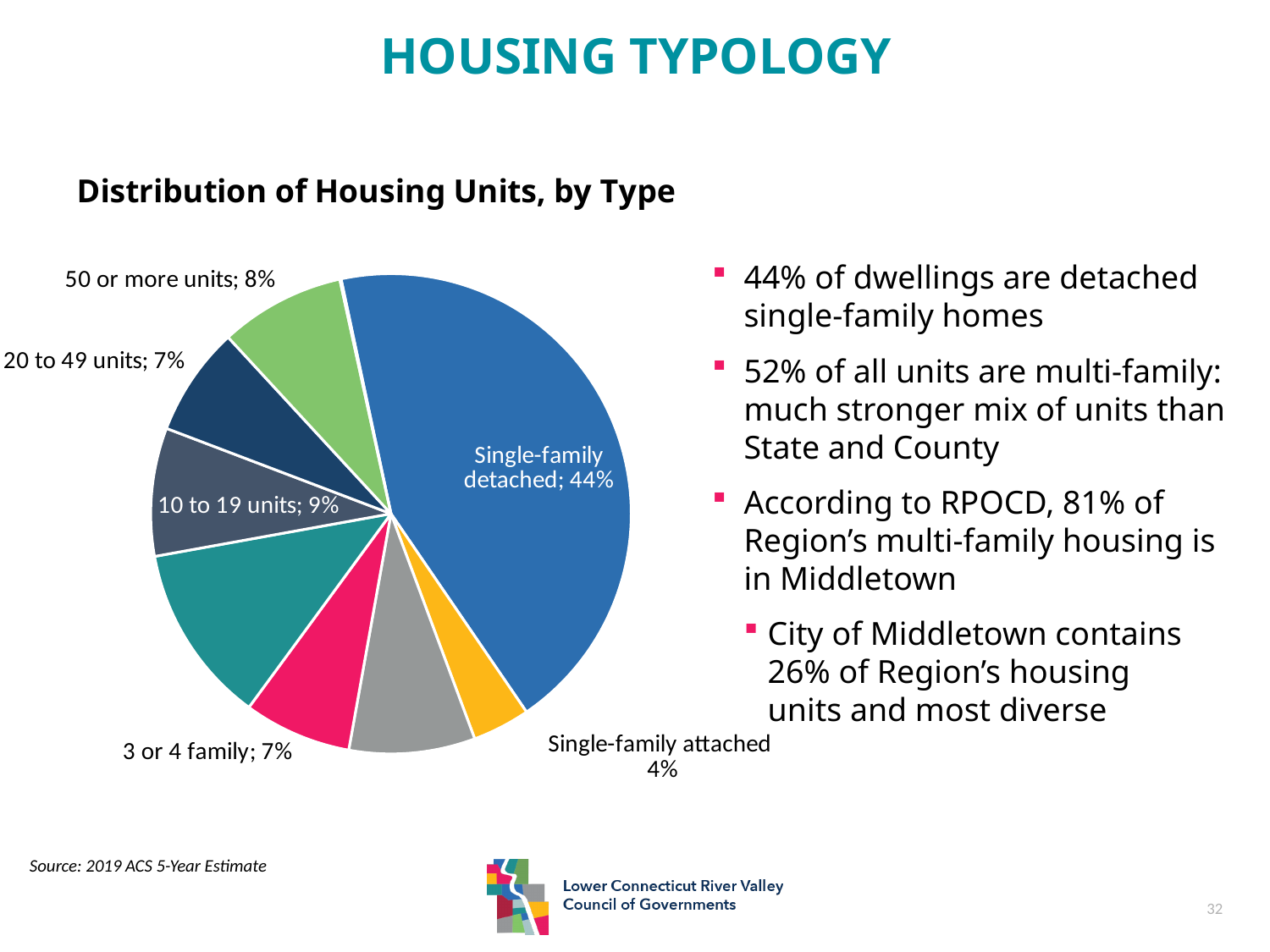
Which housing type has the smallest share of the pie? Single-family attached What share of housing units is in the 20 to 49 units category? 7% How many percentage points larger is the Single-family detached share than the 10 to 19 units share? 35% What kind of chart is shown on the slide? Pie chart Which has a larger share: 10 to 19 units or 50 or more units? 10 to 19 units What share of housing units is Single-family detached? 44% How many slices does the pie chart have? 8 What share of housing units is in the 50 or more units category? 8% What is the title of the chart? Distribution of Housing Units, by Type What share of housing units is in the 10 to 19 units category? 9% Which housing type has the largest share of the pie? Single-family detached What share of housing units is Single-family attached? 4%